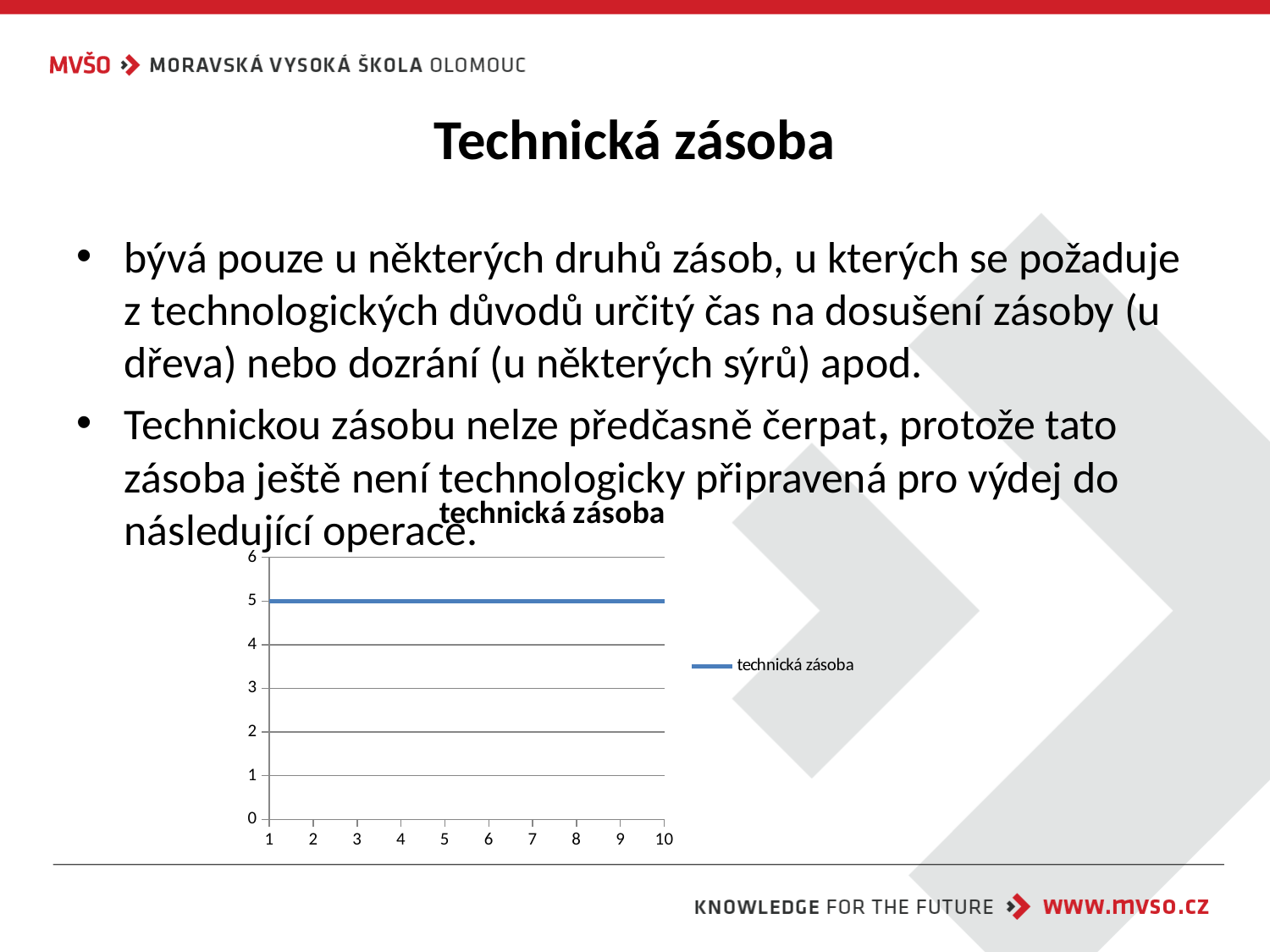
What is the value of technická zásoba at x = 1? 5 How many points are plotted along the x axis? 10 Is the value for technická zásoba at x = 5 greater or less than 4? greater What is the title of the chart? technická zásoba What is the difference between the value at x = 1 and the value at x = 10? 0 What kind of chart is shown on the slide? line chart What is the name of the series shown in the legend? technická zásoba Do the values rise, fall or stay flat along the x axis? stay flat How many series does the legend list? 1 Is the value for technická zásoba at x = 7 greater or less than 6? less What is the value of technická zásoba at x = 10? 5 What is the highest value shown on the y axis? 6